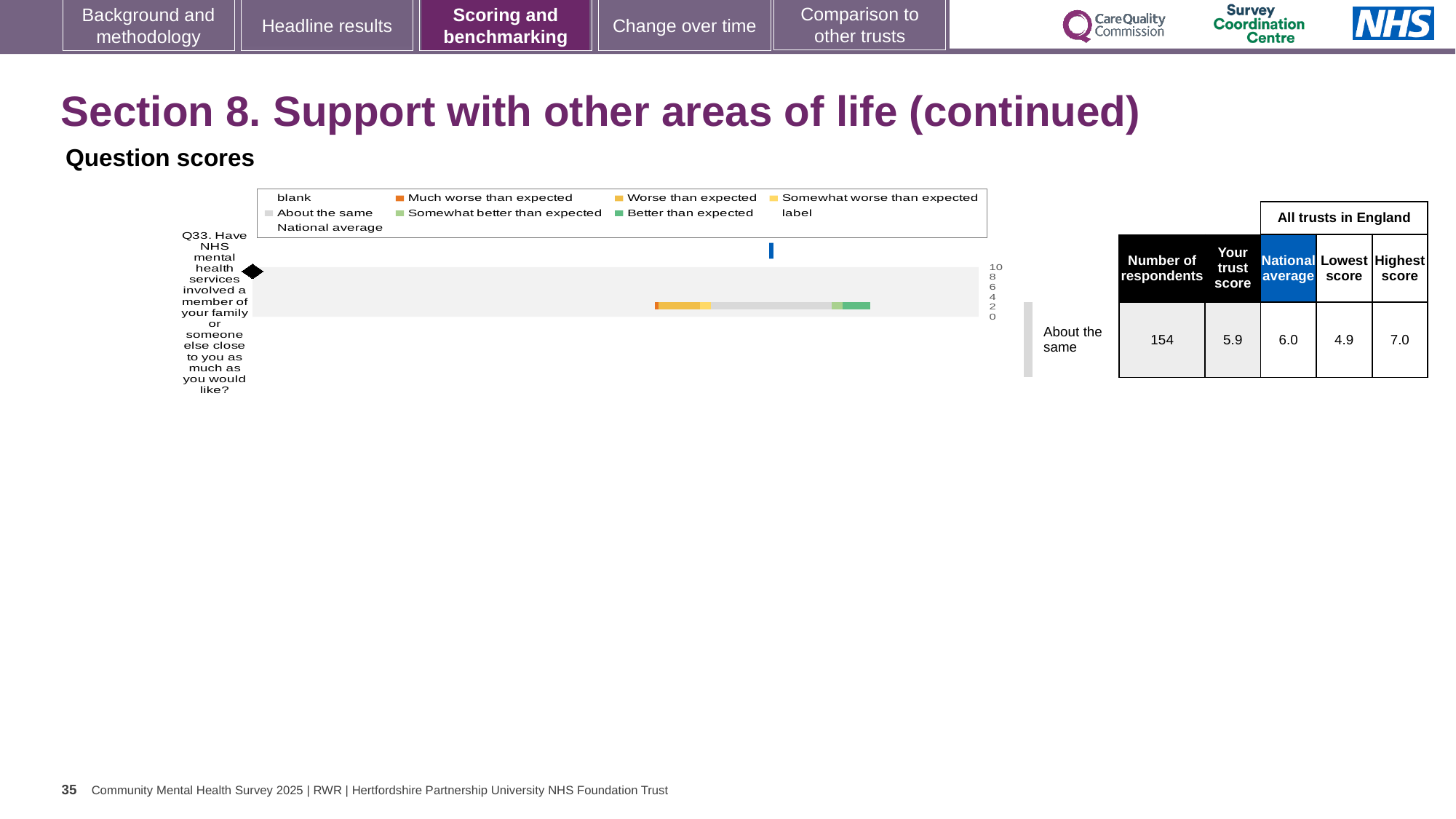
What kind of chart is shown on the slide for Q33? bar chart What is the difference between the highest score and the lowest score for Q33 in the table beside the chart? 2.1 According to the table beside the chart, what is the national average for Q33? 6.0 How many entries does the chart legend list? 9 According to the table beside the chart, what is the lowest score among all trusts in England for Q33? 4.9 According to the table beside the chart, how many respondents answered Q33? 154 Which legend entry is shown in orange? Much worse than expected According to the table beside the chart, what is the highest score among all trusts in England for Q33? 7.0 According to the table beside the chart, what is the trust's score for Q33? 5.9 Which is larger for Q33: the trust's score or the national average? national average What is the highest value shown on the chart's axis? 10 How many questions (categories) are plotted in the chart? 1